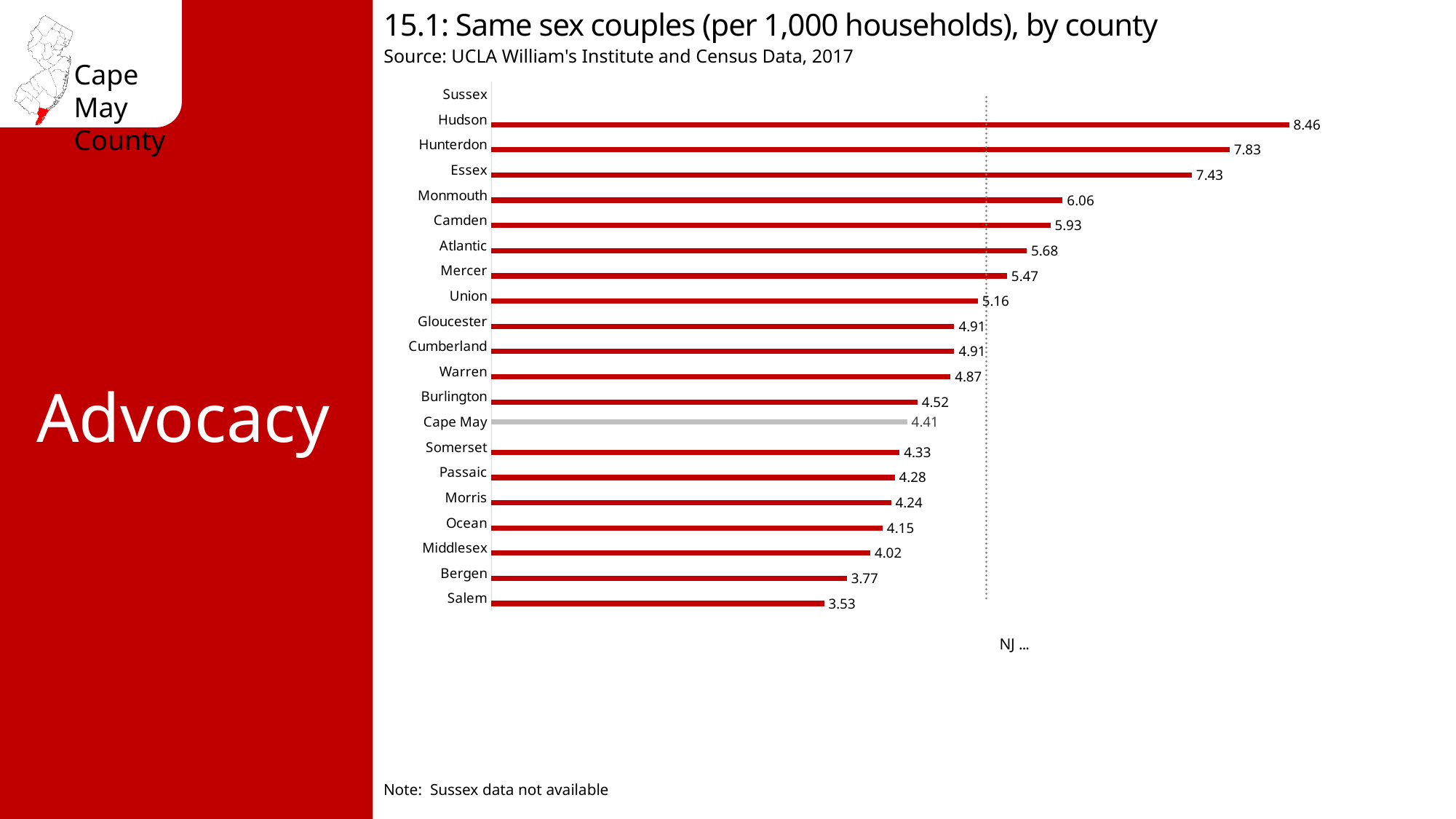
What is the value for Cape May? 4.41 Which county's bar is shown in grey instead of red? Cape May What is the value for Atlantic? 5.68 Which county has the lowest plotted value? Salem How many counties are listed on the y axis? 21 What is the value for Hudson? 8.46 Which is larger, the value for Essex or the value for Monmouth? Essex Which county has the highest value? Hudson What is the difference between the values for Hudson and Salem? 4.93 What kind of chart is this? Bar chart Which is larger, the value for Cape May or the value for Somerset? Cape May What is the difference between the values for Burlington and Cape May? 0.11